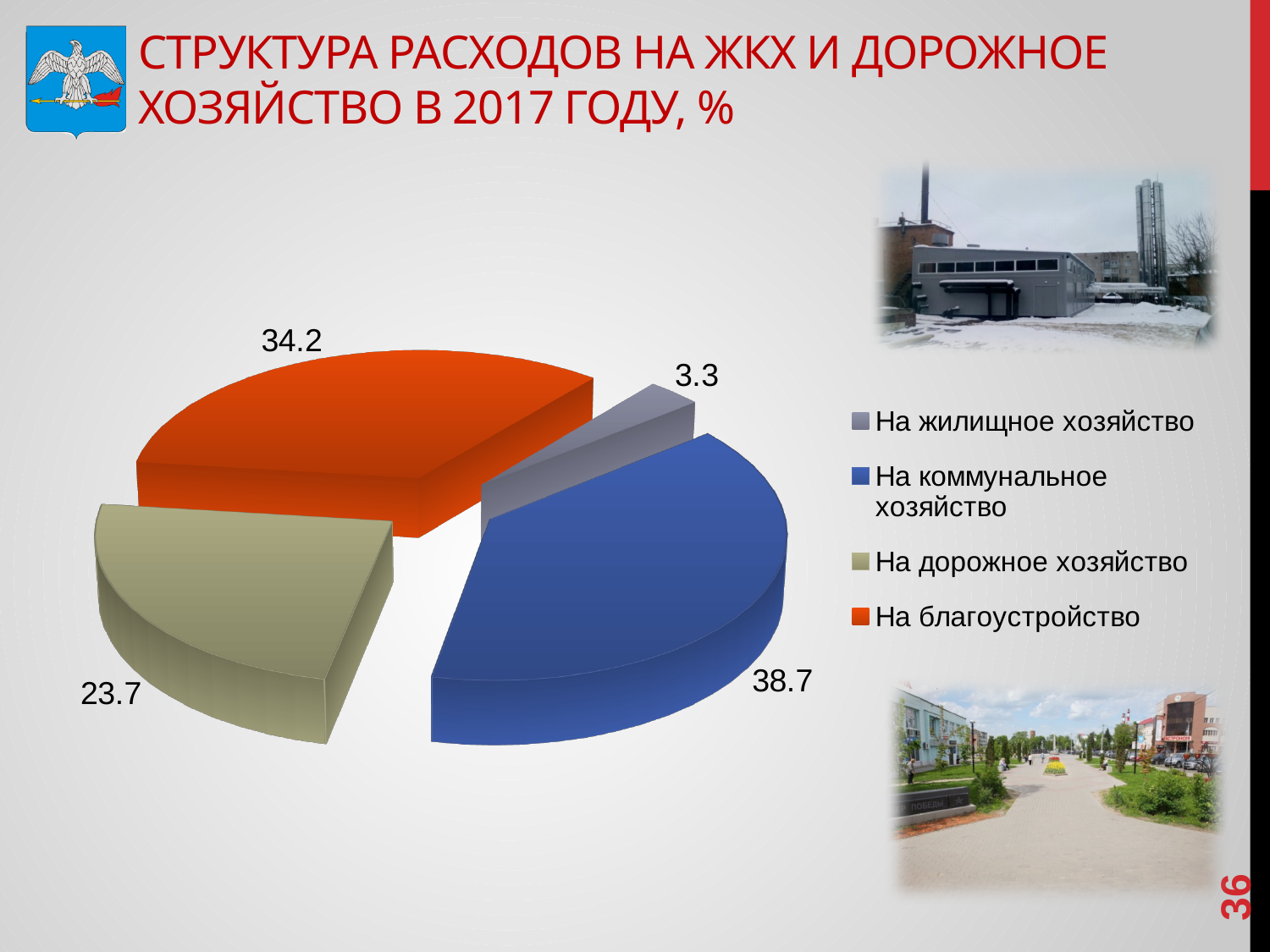
Which colour represents "На благоустройство" in the pie chart? Orange-red What is the value for "На коммунальное хозяйство"? 38.7 Which category has the smallest share of the pie? На жилищное хозяйство What is the value for "На благоустройство"? 34.2 What type of chart is shown on the slide? Pie chart What is the difference between the values for "На коммунальное хозяйство" and "На благоустройство"? 4.5 What is the value for "На жилищное хозяйство"? 3.3 What is the difference between the values for "На дорожное хозяйство" and "На жилищное хозяйство"? 20.4 How many categories does the pie chart have? 4 What is the value for "На дорожное хозяйство"? 23.7 Which category has the largest share of the pie? На коммунальное хозяйство Which is larger: the value for "На благоустройство" or the value for "На дорожное хозяйство"? На благоустройство